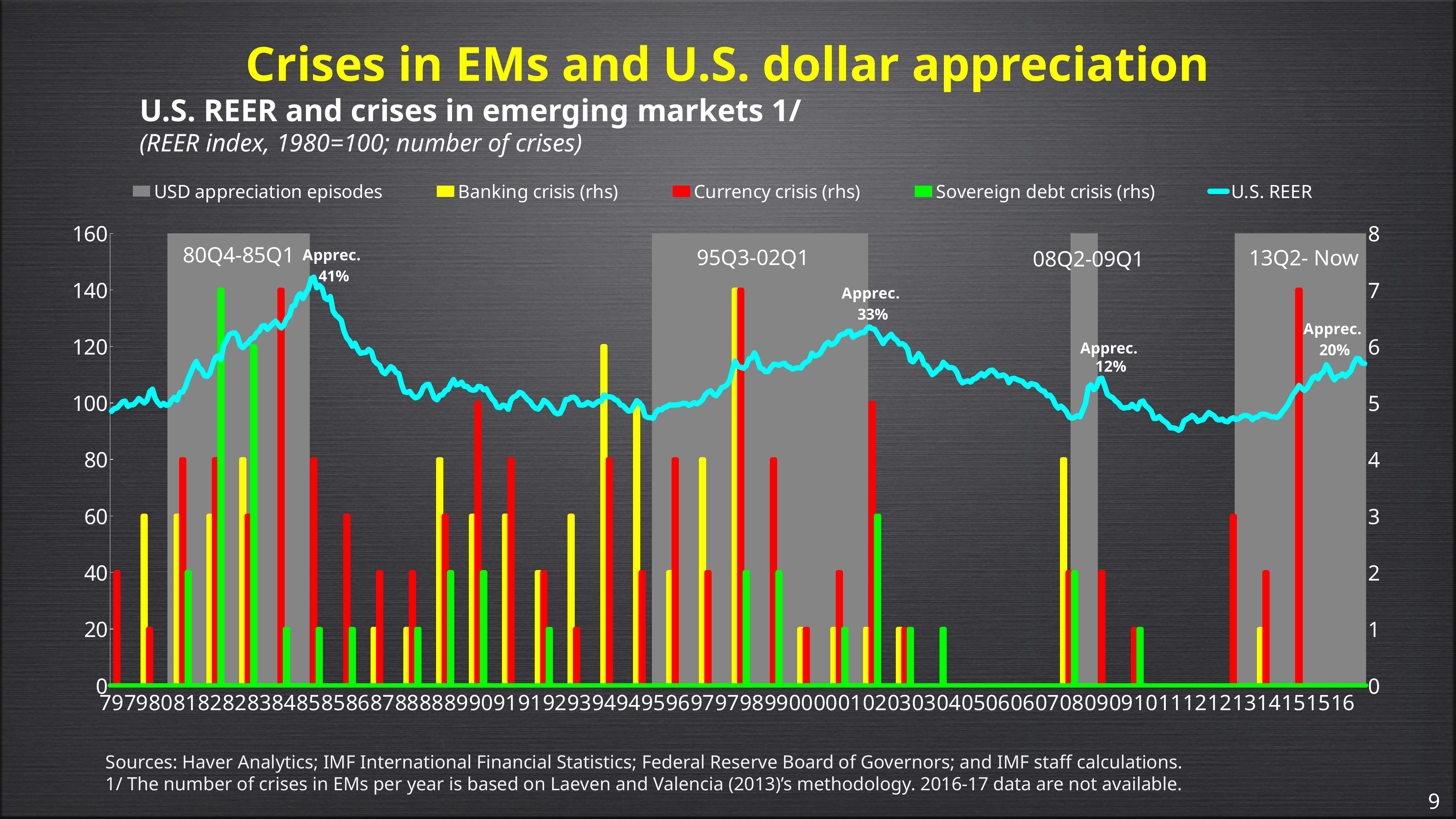
What was the U.S. dollar appreciation during the 08Q2-09Q1 episode? 12% How many USD appreciation episodes are shaded on the chart? 4 What is the difference between the appreciation in the 80Q4-85Q1 episode and the 95Q3-02Q1 episode? 8 percentage points What kind of chart is this? Combination bar and line chart What is the title of the chart? U.S. REER and crises in emerging markets 1/ What was the U.S. dollar appreciation during the 95Q3-02Q1 episode? 33% Which USD appreciation episode had the smallest appreciation? 08Q2-09Q1 What was the U.S. dollar appreciation during the 13Q2-Now episode? 20% What was the U.S. dollar appreciation during the 80Q4-85Q1 episode? 41% Is the U.S. REER value in 2011 greater or less than 100? less How many series does the chart legend list? 5 Which USD appreciation episode had the largest appreciation? 80Q4-85Q1